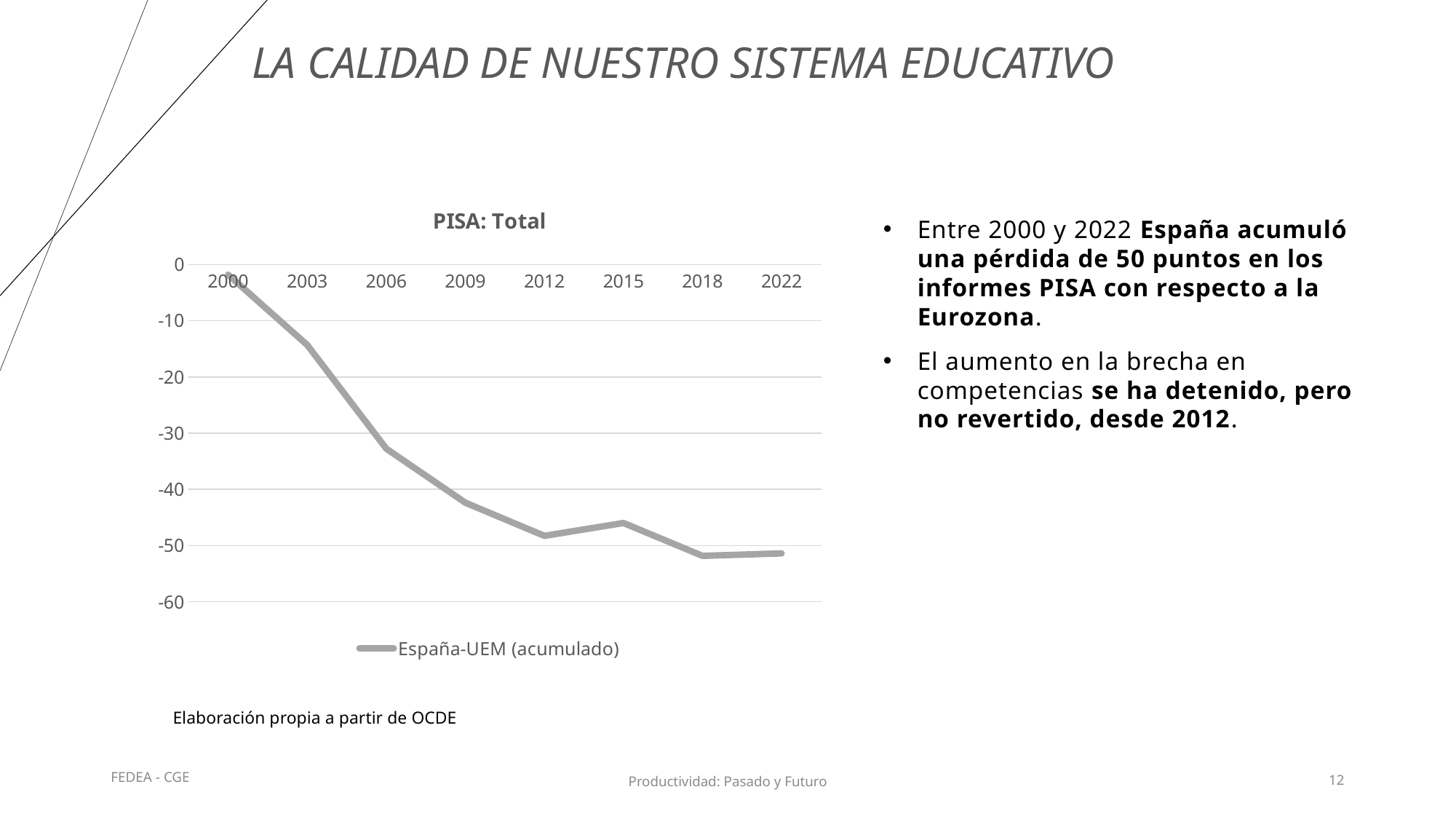
What is the name of the series shown in the legend? España-UEM (acumulado) Is the value for 2003 greater or less than -20? greater Which is larger, the value for 2012 or the value for 2015? 2015 How many series does the legend list? 1 How many years are plotted along the x axis? 8 Which year has the highest value for España-UEM (acumulado)? 2000 Is the value for 2009 greater or less than -50? greater What is the title of the chart? PISA: Total Is the value for 2006 greater or less than -30? less What kind of chart is shown on the slide? line chart Do the values of España-UEM (acumulado) generally rise or fall from 2000 to 2022? fall